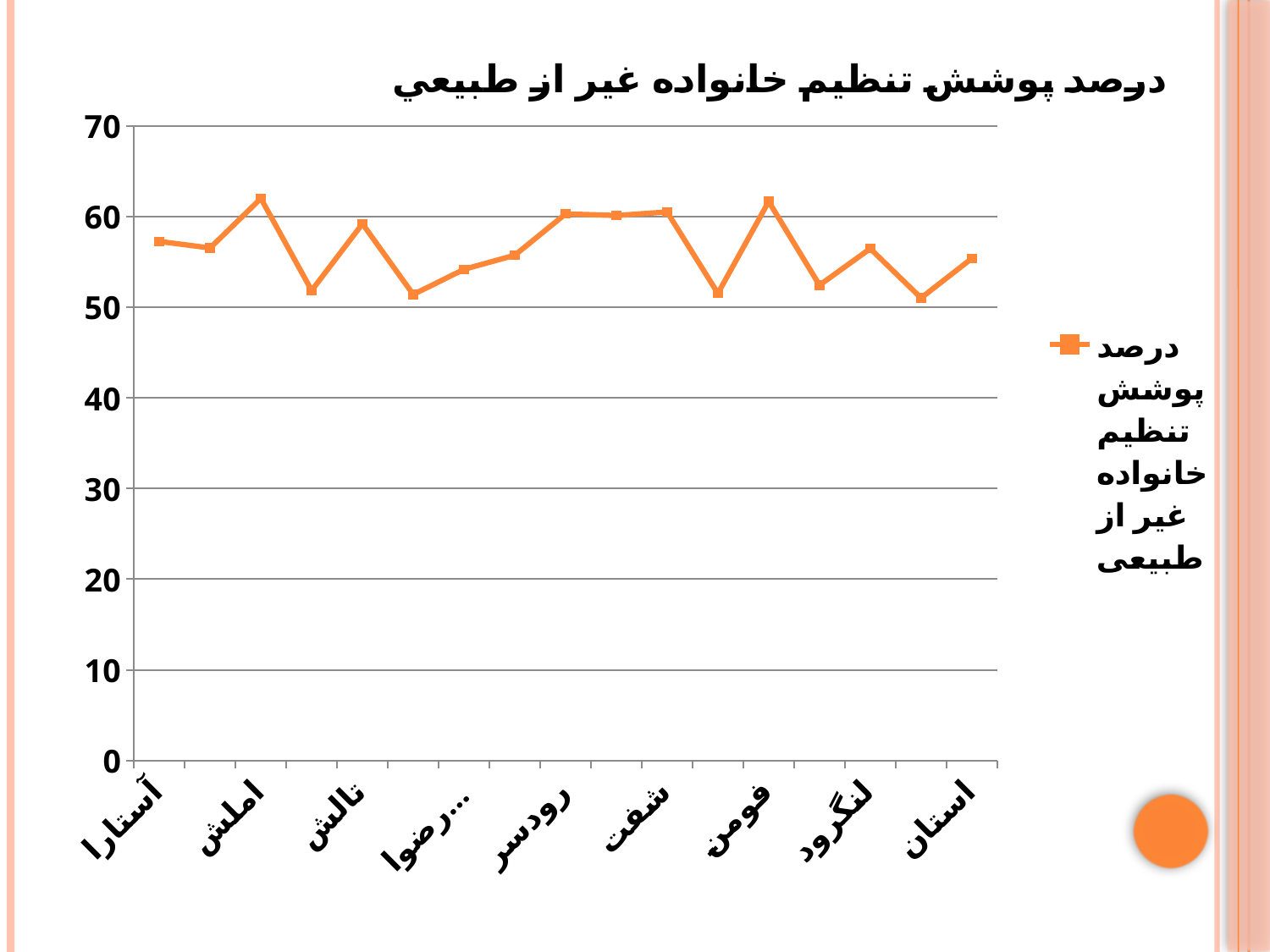
How many series does the legend list? 1 Is the value for املش greater or less than 60? greater How many data points are plotted on the line? 17 What colour is the plotted line? orange What is the title of the chart? درصد پوشش تنظيم خانواده غير از طبيعي Which has the larger value, املش or آستارا? املش Is the value for آستارا greater or less than 50? greater Is the value for استان greater or less than 50? greater What kind of chart is shown on the slide? line chart